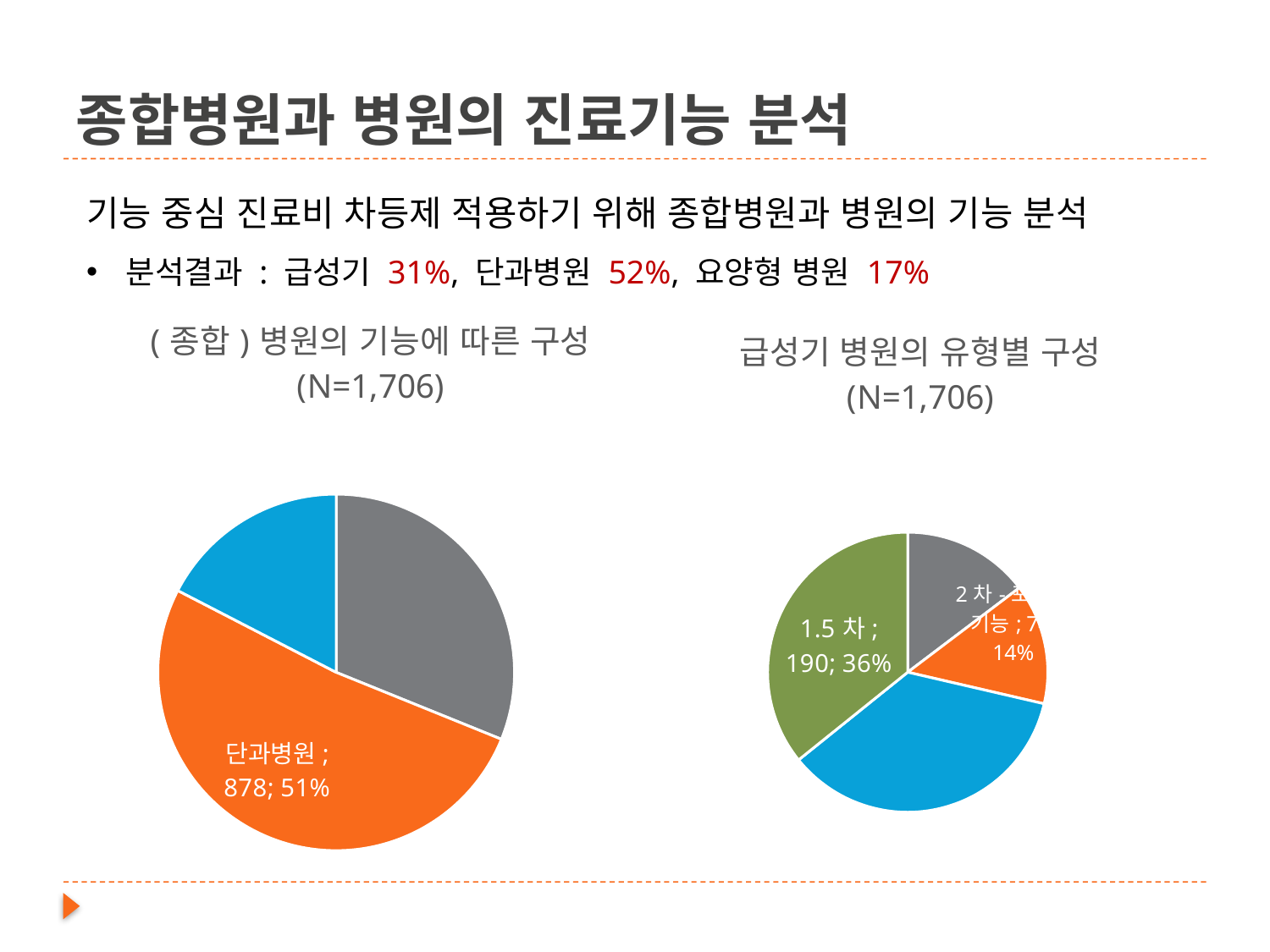
What kind of chart is the right chart titled '급성기 병원의 유형별 구성'? pie chart In the right chart '급성기 병원의 유형별 구성', what share of the pie does 1.5 차 take? 36% In the right chart '급성기 병원의 유형별 구성', what count is shown for 1.5 차? 190 In the left chart '( 종합 ) 병원의 기능에 따른 구성', what share of the pie does 단과병원 take? 51% In the left chart '( 종합 ) 병원의 기능에 따른 구성', how many slices does the pie have? 3 In the left chart '( 종합 ) 병원의 기능에 따른 구성', which colour slice is the smallest? blue In the right chart '급성기 병원의 유형별 구성', how many slices does the pie have? 4 In the left chart '( 종합 ) 병원의 기능에 따른 구성', what count is shown for 단과병원? 878 In the right chart '급성기 병원의 유형별 구성', what is the difference in percentage points between the 1.5 차 slice (36%) and the orange slice (14%)? 22% In the right chart '급성기 병원의 유형별 구성', what percentage is printed on the orange slice? 14% What kind of chart is the left chart titled '( 종합 ) 병원의 기능에 따른 구성'? pie chart In the left chart '( 종합 ) 병원의 기능에 따른 구성', which slice is the largest? 단과병원